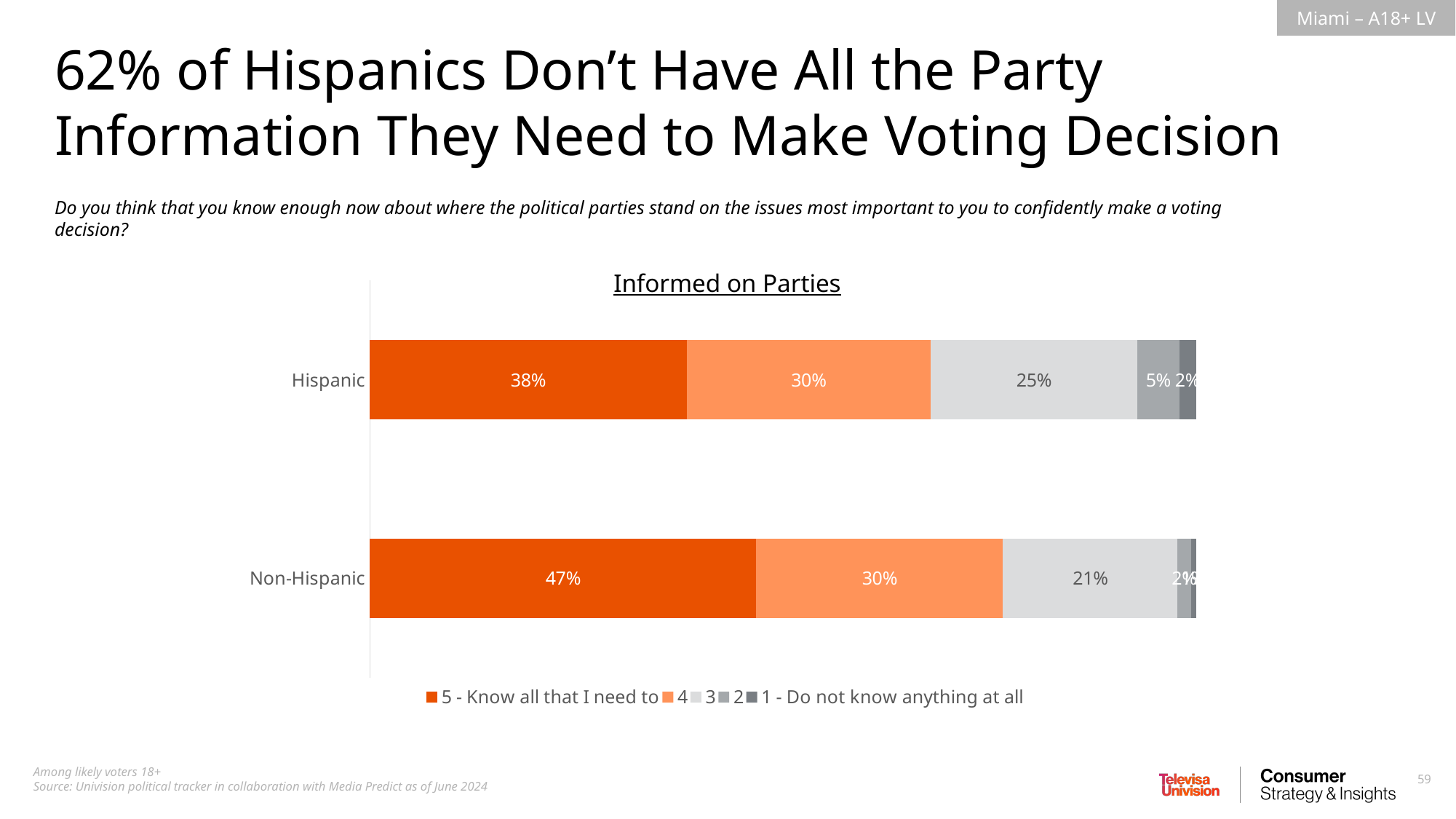
What is the difference in percentage points between Non-Hispanic and Hispanic respondents answering "5 - Know all that I need to"? 9 percentage points How many series does the legend list? 5 What percentage of Hispanic respondents answered "5 - Know all that I need to"? 38% How many groups (bars) are shown in the chart? 2 What is the value of the "2" segment for Hispanic respondents? 5% What is the value of the "3" segment for Hispanic respondents? 25% Which response segment is the largest in the Hispanic bar? 5 - Know all that I need to Which group has the larger share answering "5 - Know all that I need to", Hispanic or Non-Hispanic? Non-Hispanic What is the value of the "3" segment for Non-Hispanic respondents? 21% What percentage of Non-Hispanic respondents answered "5 - Know all that I need to"? 47% What is the difference in percentage points between the "3" segments for Hispanic and Non-Hispanic respondents? 4 percentage points What type of chart is shown on the slide? Stacked bar chart